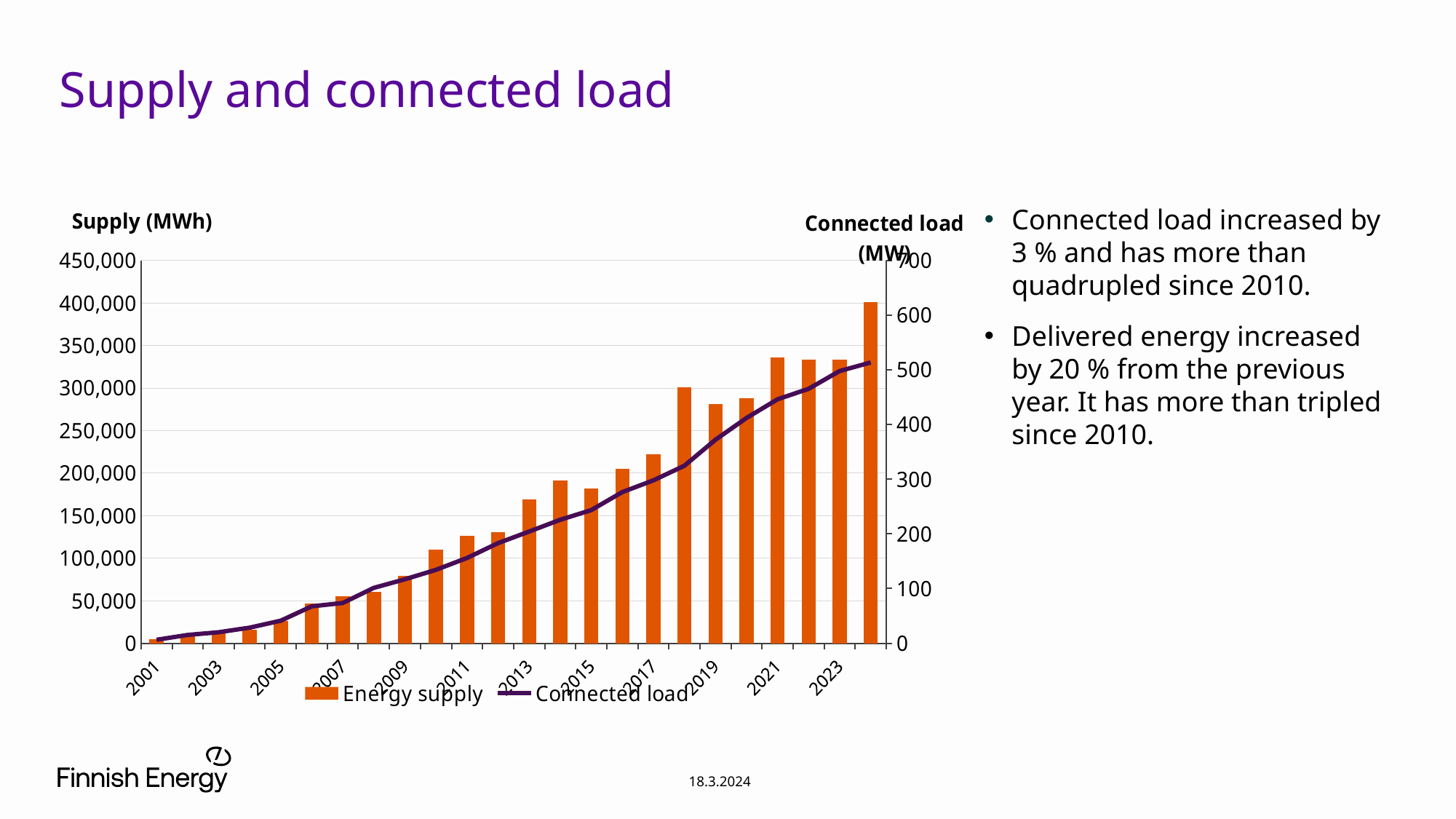
What is the title of the left vertical axis? Supply (MWh) What are the two series named in the legend? Energy supply and Connected load Is the Connected load value for 2021 greater or less than 400? greater Which year has the larger Energy supply, 2017 or 2019? 2019 Is the Energy supply value for 2013 greater or less than 200,000? less Is the Energy supply value for 2005 greater or less than 50,000? less Does Energy supply generally rise or fall from 2001 to the last year shown? Rise How many bars (years) are plotted for Energy supply? 24 Which labelled year has the lowest Energy supply bar? 2001 What kind of chart is shown on the slide? A bar chart combined with a line chart How many series does the legend list? 2